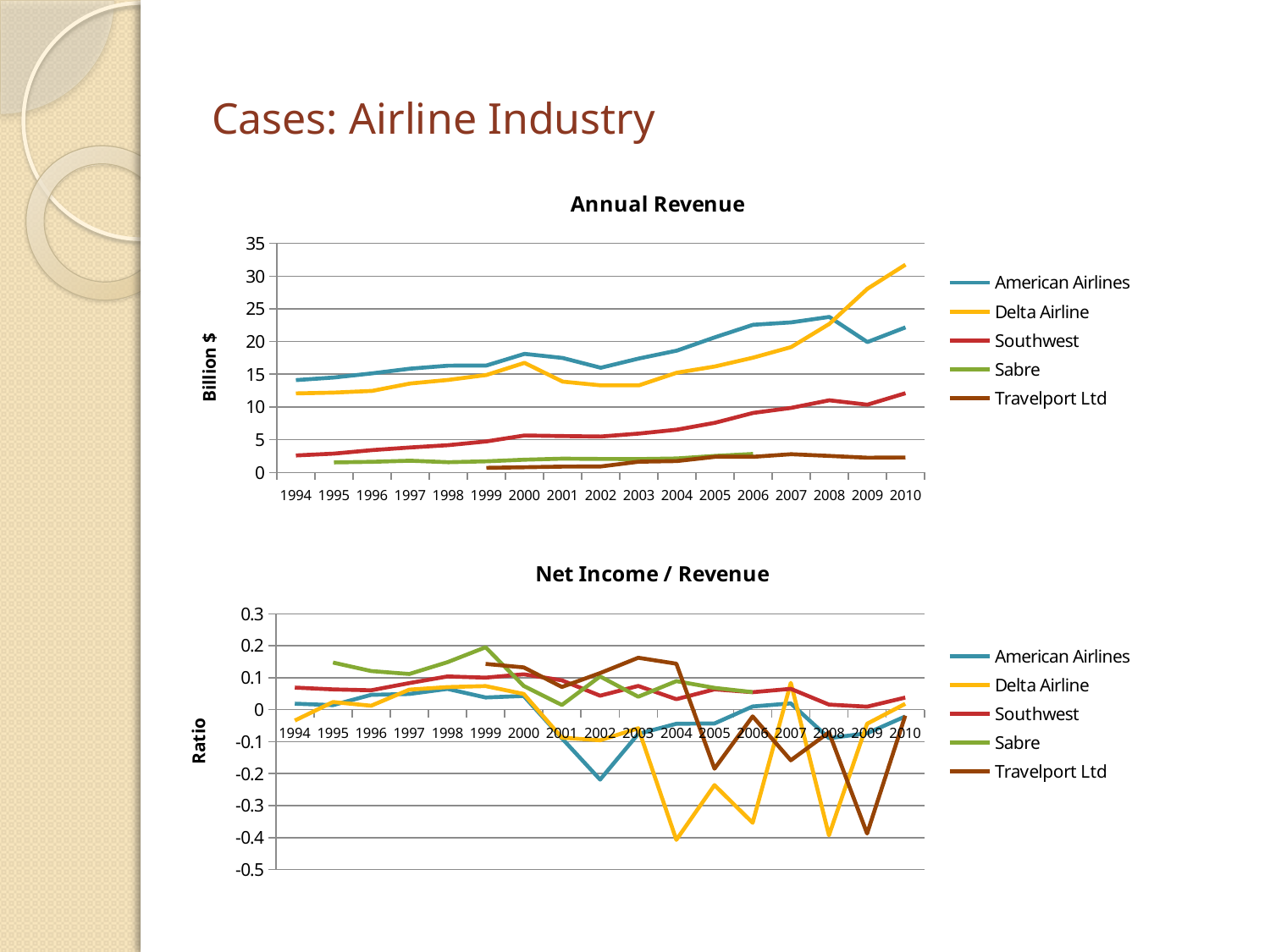
In the Annual Revenue chart, which is larger in 2008: American Airlines or Southwest? American Airlines In the Annual Revenue chart, is the value for Delta Airline in 2010 greater or less than 30? greater In the Net Income / Revenue chart, which series has the lowest value in 2004? Delta Airline What type of chart is the Annual Revenue chart? line chart How many series does the legend of the Annual Revenue chart list? 5 What is the y-axis label of the Annual Revenue chart? Billion $ How many years are shown on the x axis of the Annual Revenue chart? 17 In the Annual Revenue chart, does the Southwest line generally rise or fall from 1994 to 2010? rise In the Annual Revenue chart, which series has the highest value in 2010? Delta Airline In the Annual Revenue chart, which series has the lowest value in 2010? Travelport Ltd In the Net Income / Revenue chart, is the value for Delta Airline in 2004 greater or less than -0.3? less In the Annual Revenue chart, is the value for Southwest in 1994 greater or less than 5? less